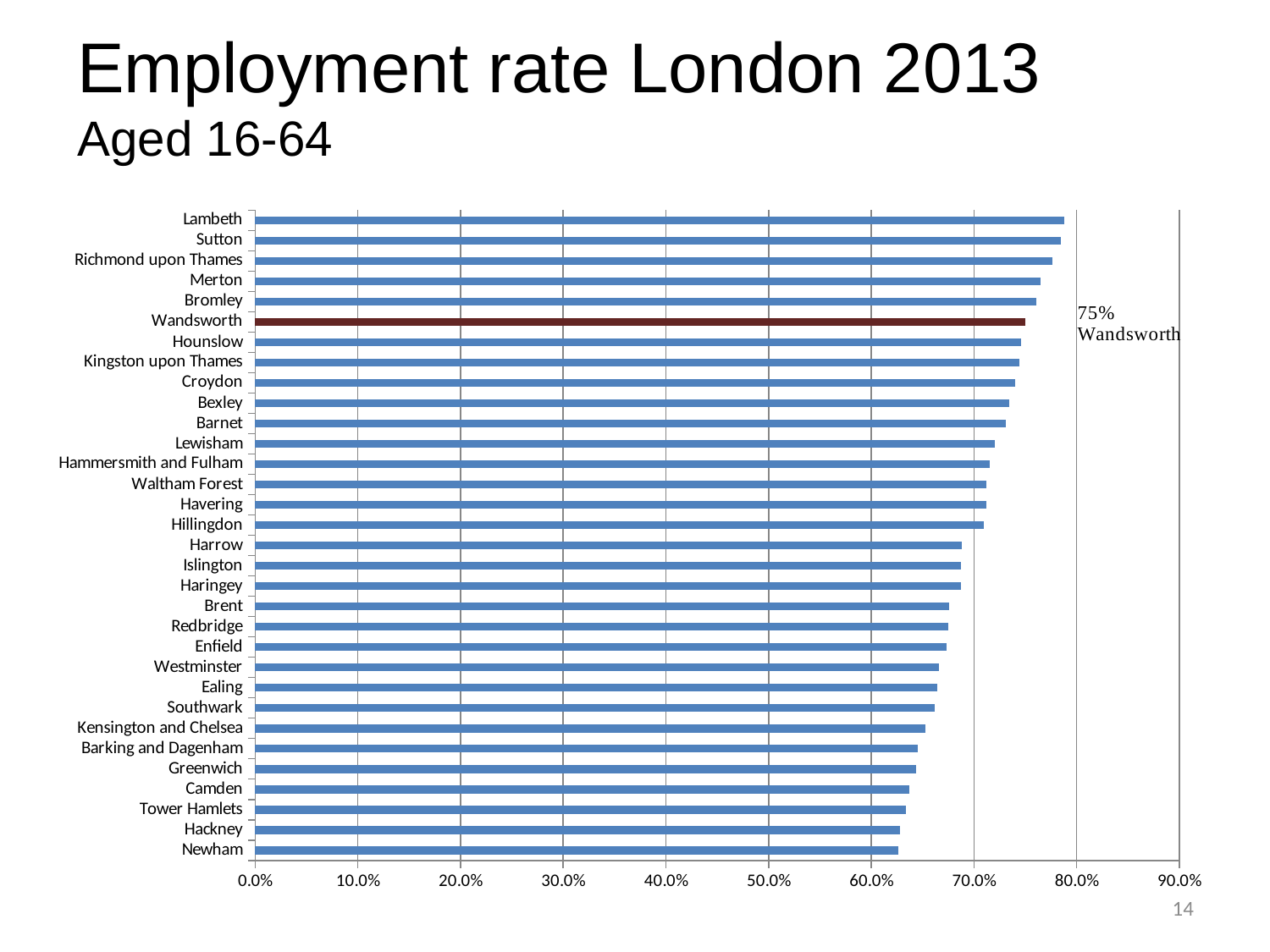
Is the value for Lambeth greater or less than 70.0%? greater Is the value for Bromley greater or less than 70.0%? greater Which has the higher employment rate, Merton or Tower Hamlets? Merton Is the value for Camden greater or less than 70.0%? less What type of chart is shown on the slide? bar chart How many London boroughs are listed on the chart? 32 Which borough's bar is highlighted in a different colour from the others? Wandsworth What is the employment rate shown for Wandsworth? 75% Do the bar values rise or fall going from the top of the chart (Lambeth) to the bottom (Newham)? fall Which has the higher employment rate, Lambeth or Newham? Lambeth